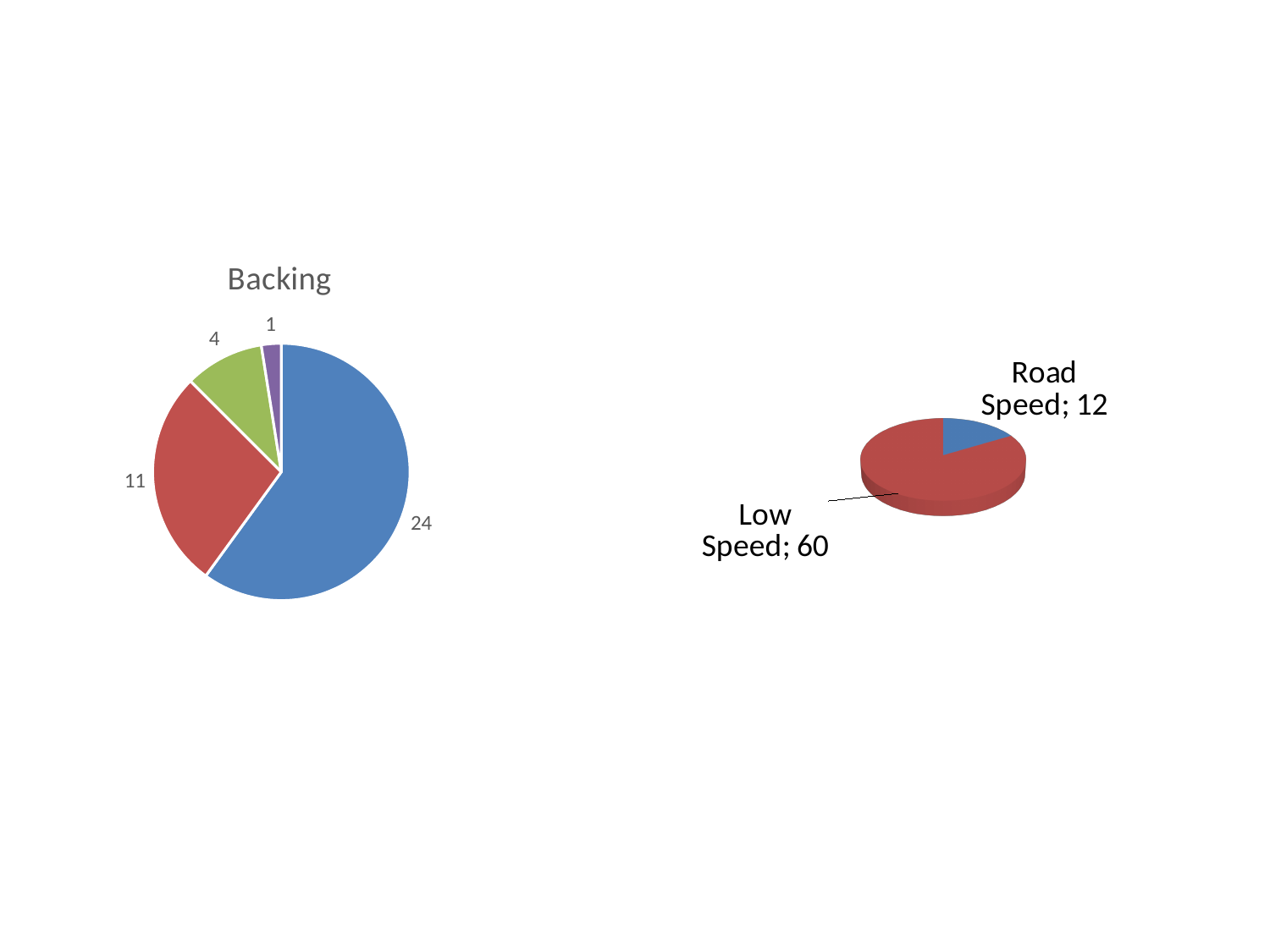
In the pie chart on the right of the slide, what is the value for Low Speed? 60 What is the title of the pie chart on the left of the slide? Backing In the pie chart on the right of the slide, which category is larger, Road Speed or Low Speed? Low Speed In the pie chart on the right of the slide, what is the value for Road Speed? 12 In the "Backing" pie chart, what share of the total does the largest slice (24) represent? 60% In the "Backing" pie chart, what is the difference between the blue slice (24) and the red slice (11)? 13 How many slices does the "Backing" pie chart have? 4 In the "Backing" pie chart, what is the value of the largest slice? 24 In the "Backing" pie chart, what is the total of all the slice values? 40 In the "Backing" pie chart, what is the value of the smallest slice? 1 In the pie chart on the right of the slide, what is the difference between Low Speed and Road Speed? 48 What kind of chart is the chart titled "Backing" on the left of the slide? pie chart